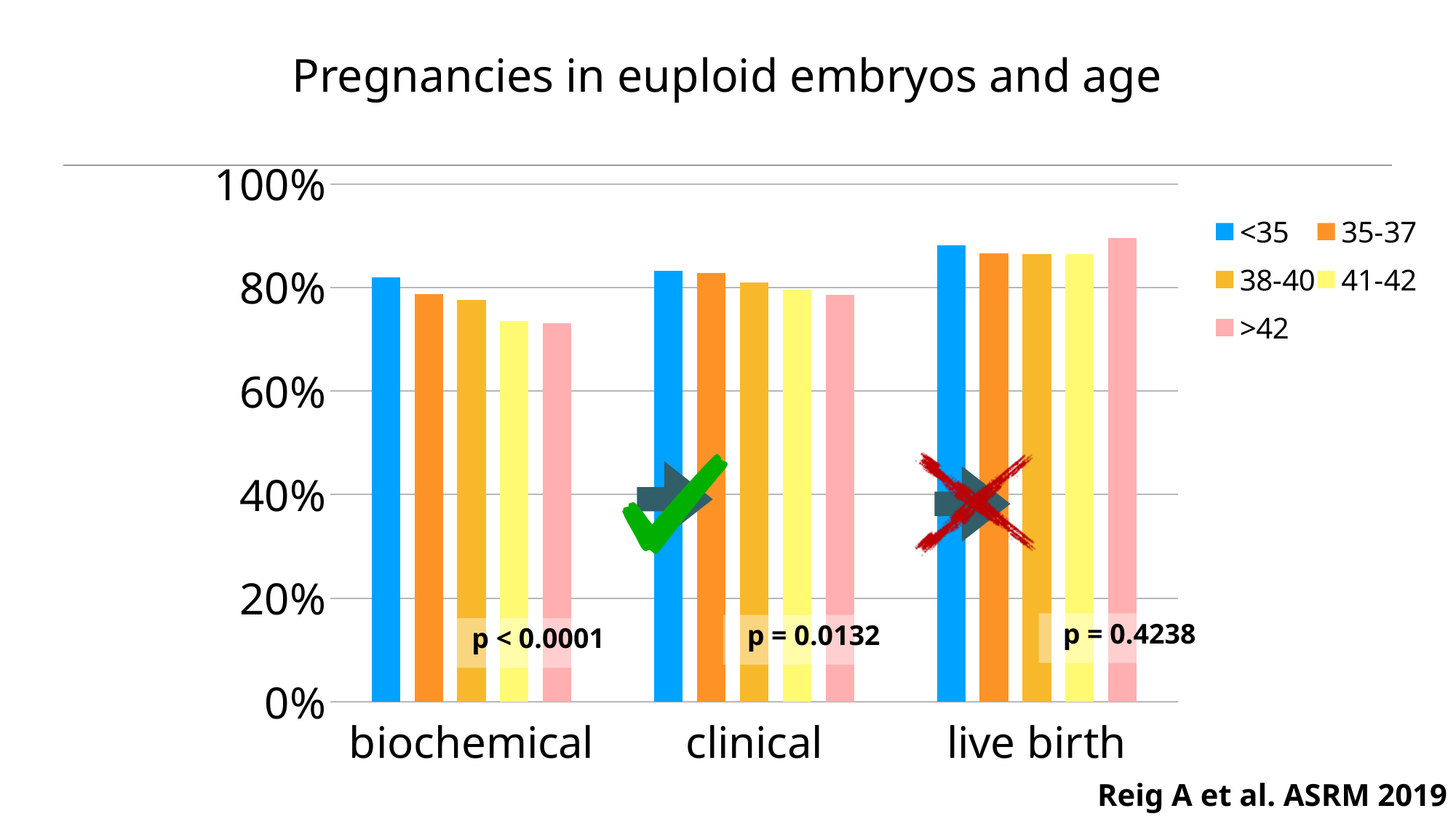
Is the value for <35 in the biochemical category greater or less than 80%? greater Is the value for 41-42 in the biochemical category greater or less than 80%? less For the >42 series, which is larger: the value for biochemical or the value for live birth? live birth How many series does the legend list? 5 In the biochemical category, which age group has the highest value? <35 Is the value for >42 in the biochemical category greater or less than 80%? less How many categories are shown on the x axis? 3 In the biochemical category, which is larger: the value for <35 or the value for >42? <35 Do the values for the >42 series rise or fall from biochemical to live birth? rise What p-value is shown for the biochemical category? p < 0.0001 What kind of chart is shown on the slide? bar chart